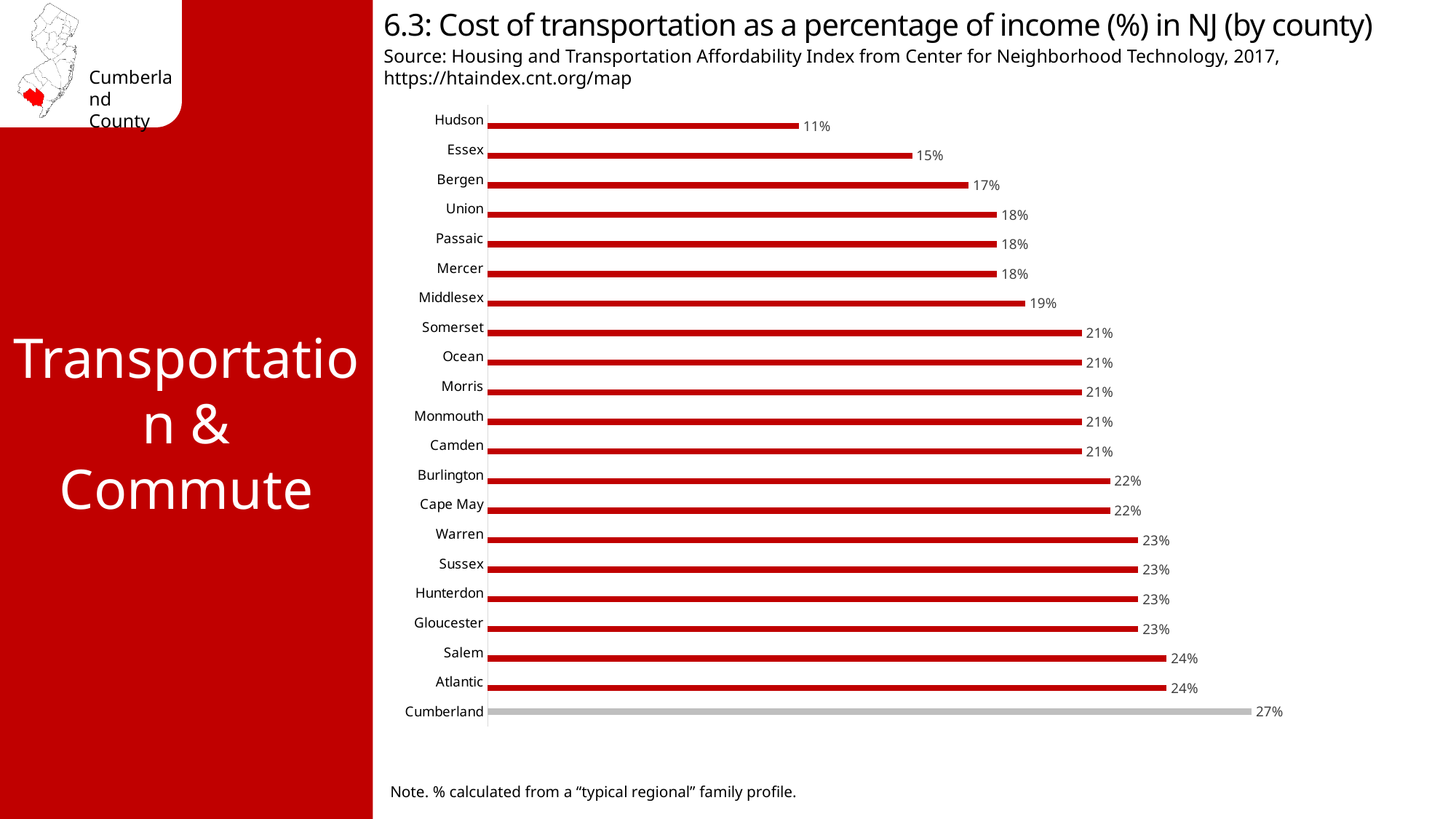
What is the cost of transportation as a percentage of income for Cumberland County? 27% How many counties are shown in the chart? 21 What type of chart is shown on the slide? Bar chart Which has a higher value, Bergen or Gloucester? Gloucester What is the value shown for Middlesex County? 19% What is the value shown for Hudson County? 11% What is the value shown for Cape May County? 22% Which county has the highest cost of transportation as a percentage of income? Cumberland Which county's bar is drawn in grey rather than red? Cumberland What is the difference between the values for Salem and Essex? 9% What is the difference between the values for Cumberland and Hudson? 16% Which county has the lowest cost of transportation as a percentage of income? Hudson